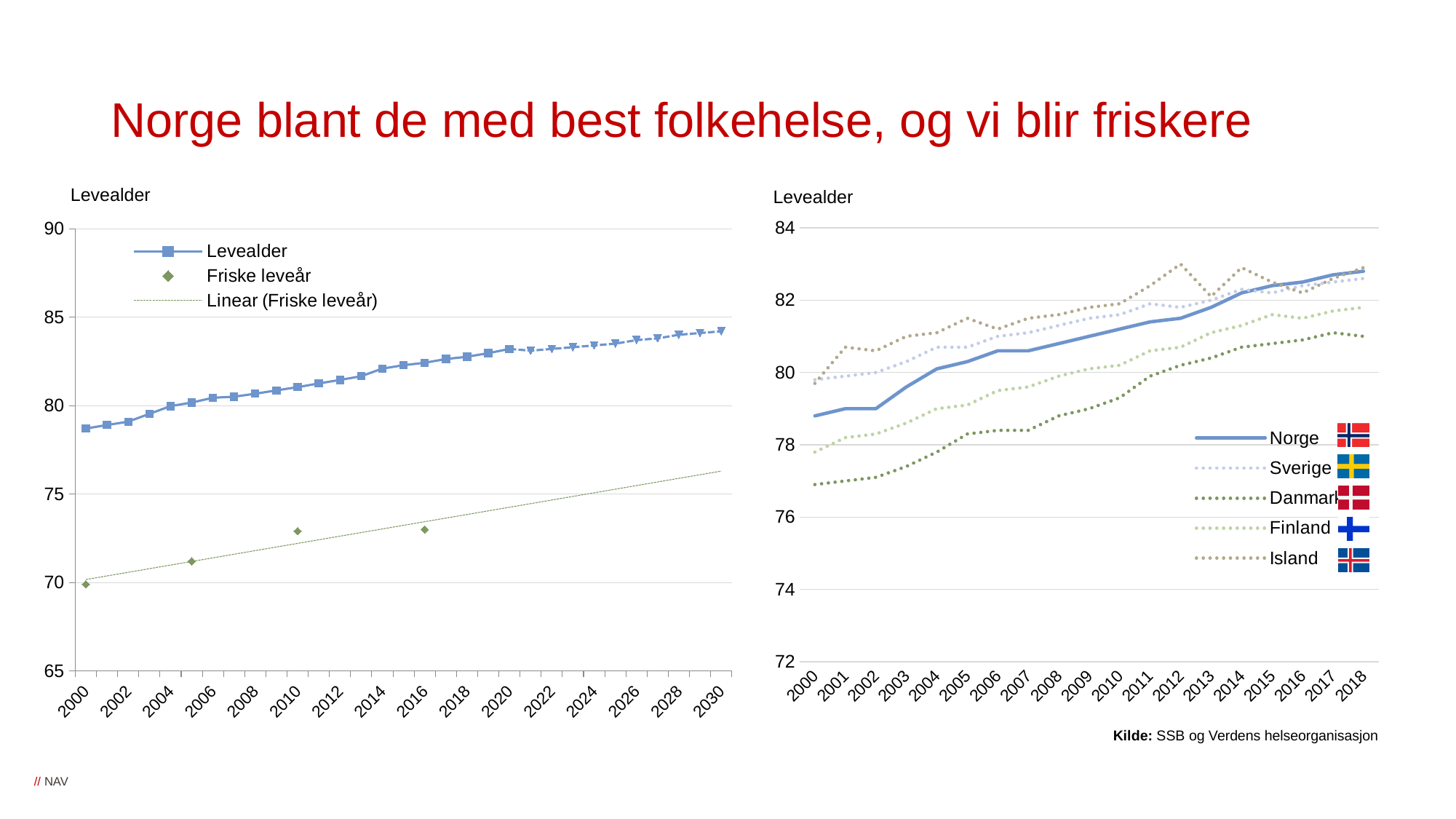
In the right chart, is the value for Danmark in 2000 greater or less than 78? less What kind of chart is the left chart titled 'Levealder'? line chart In the left chart, does the Levealder series rise or fall from 2000 to 2030? rise How many series does the legend of the left chart list? 3 In the left chart, is the Levealder value for 2000 greater or less than 80? less How many series does the legend of the right chart list? 5 In the right chart, does the Danmark series rise or fall from 2000 to 2018? rise In the right chart, how many years are shown on the x axis? 19 In the right chart, which country has the lowest value in 2018? Danmark Which countries are listed in the legend of the right chart? Norge, Sverige, Danmark, Finland, Island In the right chart, which is larger in 2000: the value for Norge or the value for Danmark? Norge In the left chart, is the Friske leveår value for 2010 greater or less than 70? greater